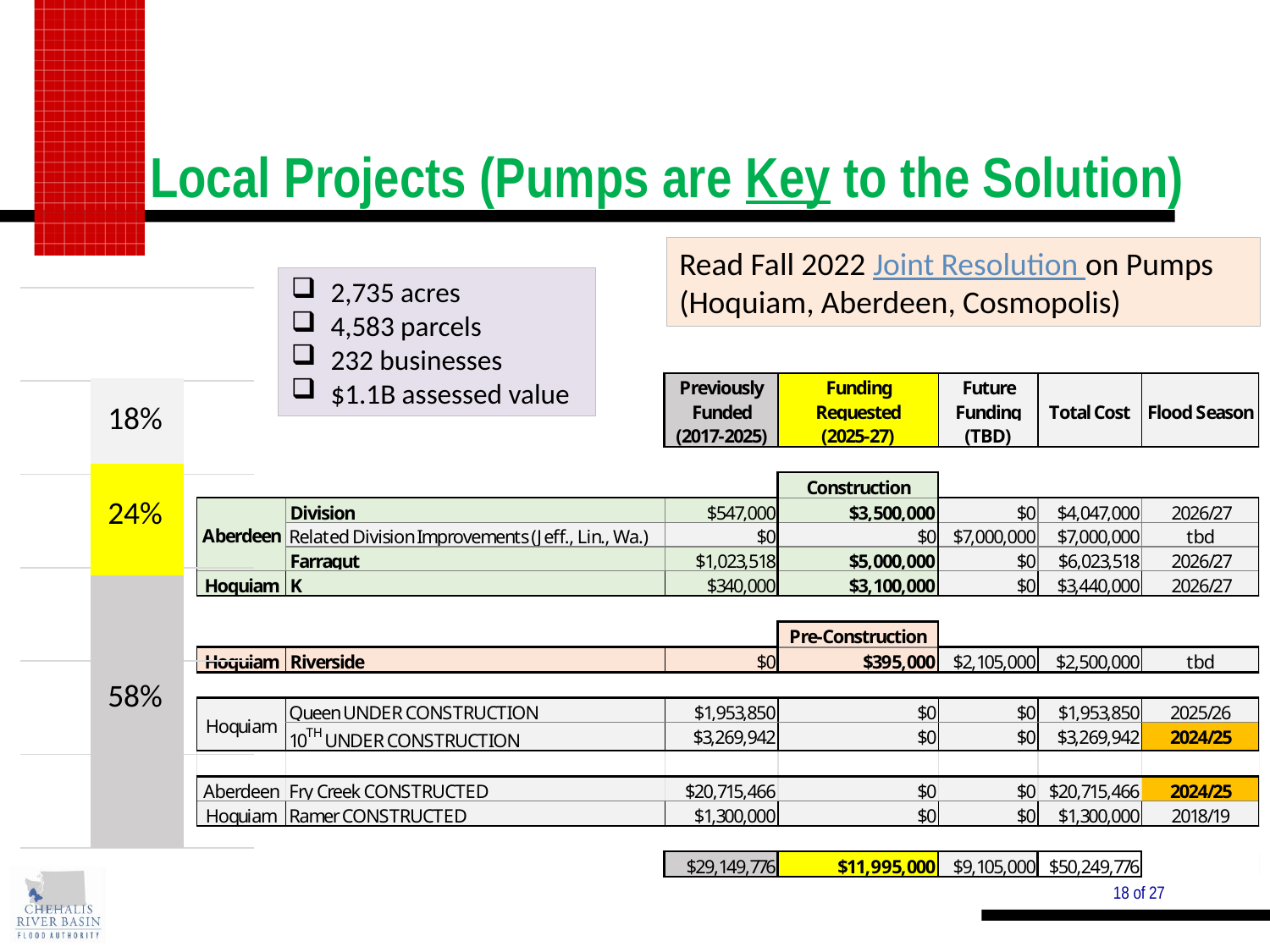
What is the total of all segments in the stacked bar on the left of the slide? 100% Which segment of the stacked bar on the left of the slide has the largest value? 58% What is the value of the yellow segment of the stacked bar on the left of the slide? 24% What colour is the 24% segment of the stacked bar on the left of the slide? yellow In the stacked bar on the left of the slide, what is the difference between the gray segment (58%) and the yellow segment (24%)? 34% What is the value of the top segment of the stacked bar on the left of the slide? 18% What kind of chart is shown on the left side of the slide? bar chart Which segment of the stacked bar on the left of the slide has the smallest value? 18% What is the value of the gray segment at the bottom of the stacked bar on the left of the slide? 58% How many segments does the stacked bar on the left of the slide have? 3 In the stacked bar on the left of the slide, which is larger: the yellow segment or the gray segment? the gray segment In the stacked bar on the left of the slide, what is the difference between the yellow segment (24%) and the top segment (18%)? 6%